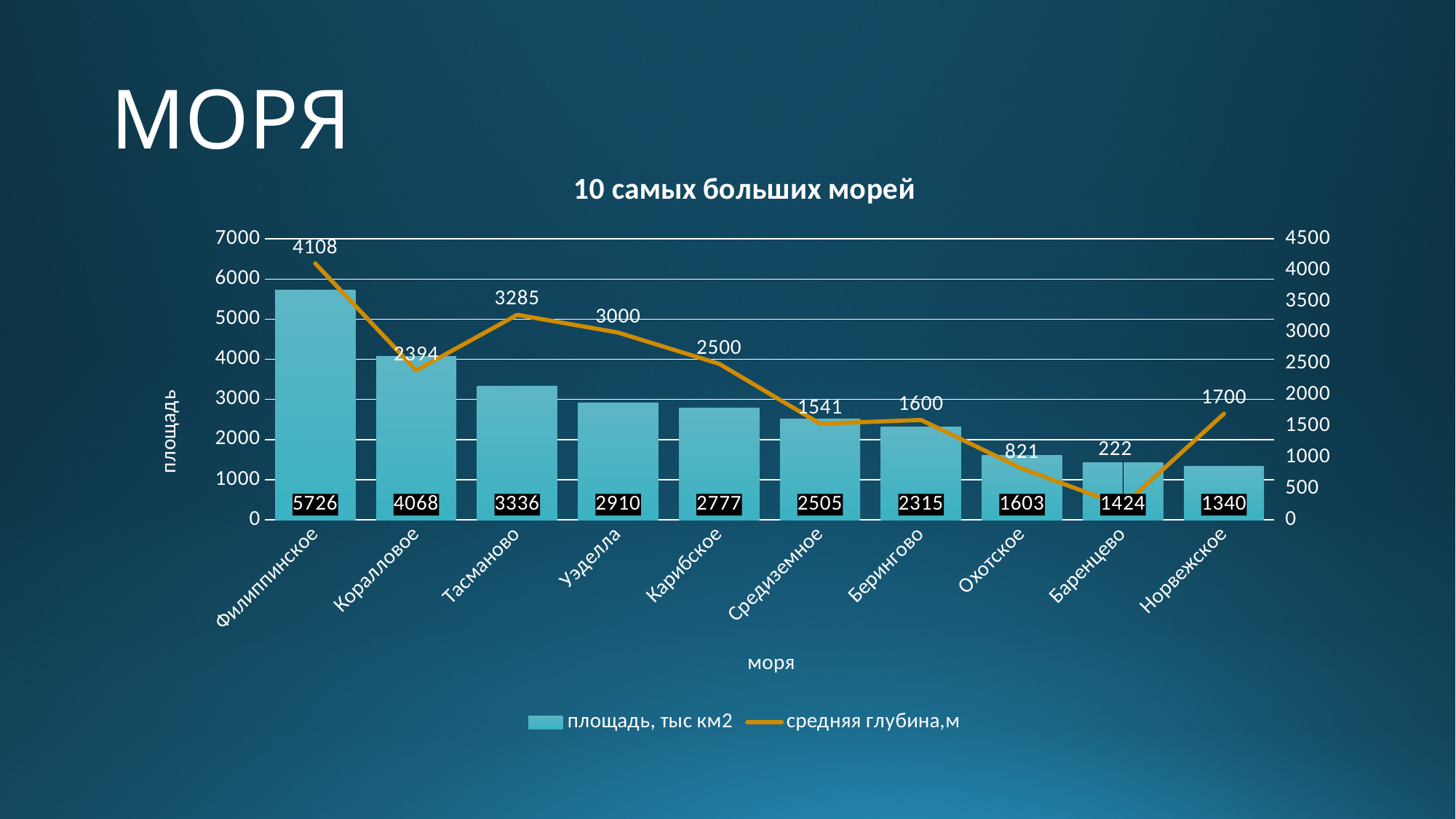
What is the area (площадь, тыс км2) of the Филиппинское sea? 5726 How many series does the legend list? 2 What kind of chart is this? Combined bar and line chart What is the difference in area between the Коралловое and Тасманово seas? 732 Do the area bars rise or fall from left to right along the x axis? Fall Which sea has the smallest average depth? Баренцево Which has a greater average depth, Берингово or Охотское? Берингово What is the title of the chart? 10 самых больших морей What is the average depth (средняя глубина, м) of the Тасманово sea? 3285 How many seas are shown on the chart? 10 What is the area (площадь, тыс км2) of the Охотское sea? 1603 Which sea has the largest area? Филиппинское